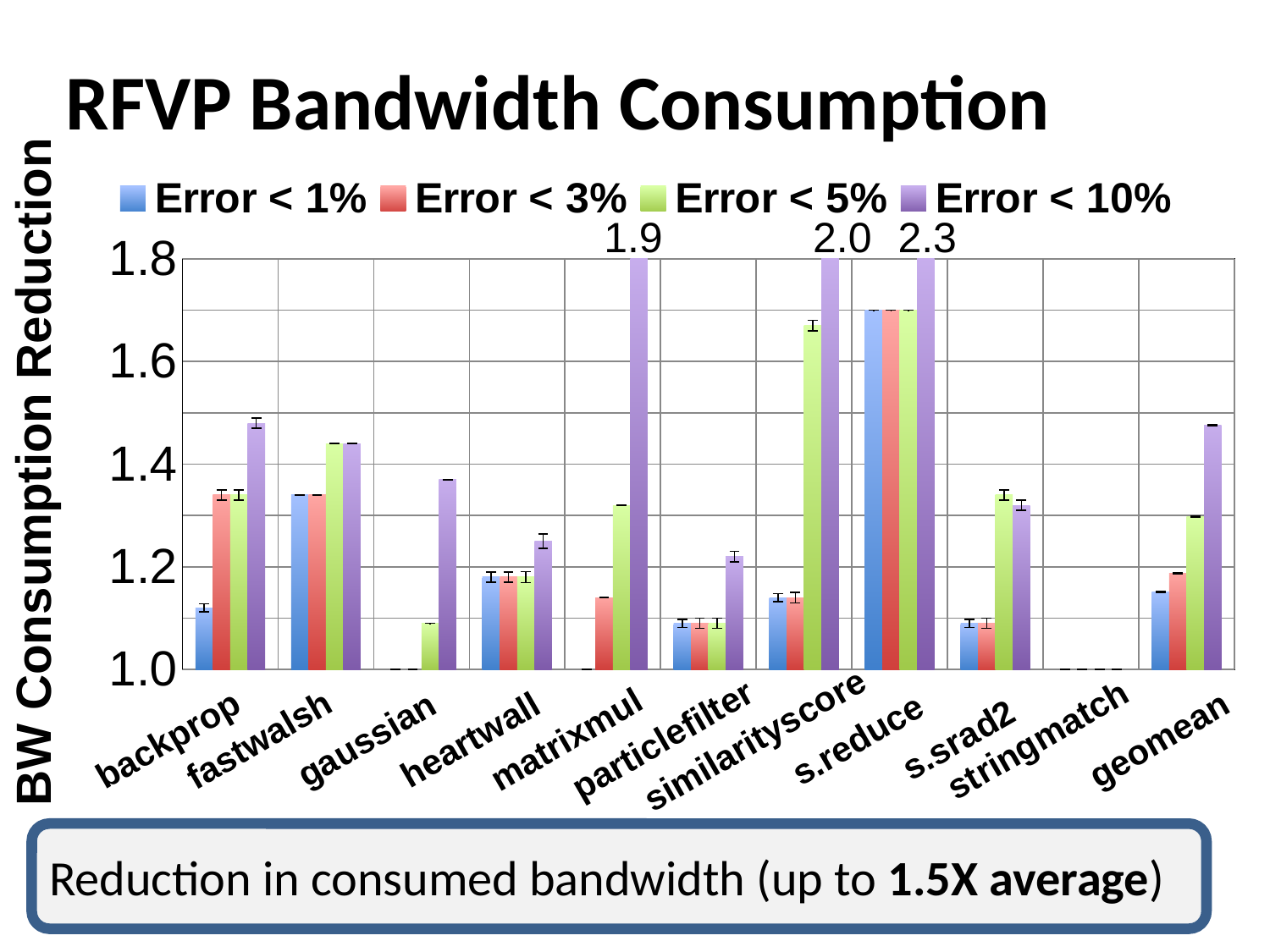
What is the BW consumption reduction for matrixmul with Error < 10%? 1.9 What is the title of the y axis? BW Consumption Reduction What is the BW consumption reduction for s.reduce with Error < 10%? 2.3 Is the Error < 10% value for geomean greater or less than 1.4? greater How many series does the legend list? 4 What is the difference between the Error < 10% values for s.reduce and matrixmul? 0.4 Which category has the highest Error < 10% value? s.reduce How many categories are shown along the x axis? 11 Is the Error < 1% value for backprop greater or less than 1.2? less What kind of chart is shown on the slide? bar chart Which is larger, the Error < 5% value for fastwalsh or the Error < 5% value for backprop? fastwalsh What is the BW consumption reduction for similarityscore with Error < 10%? 2.0